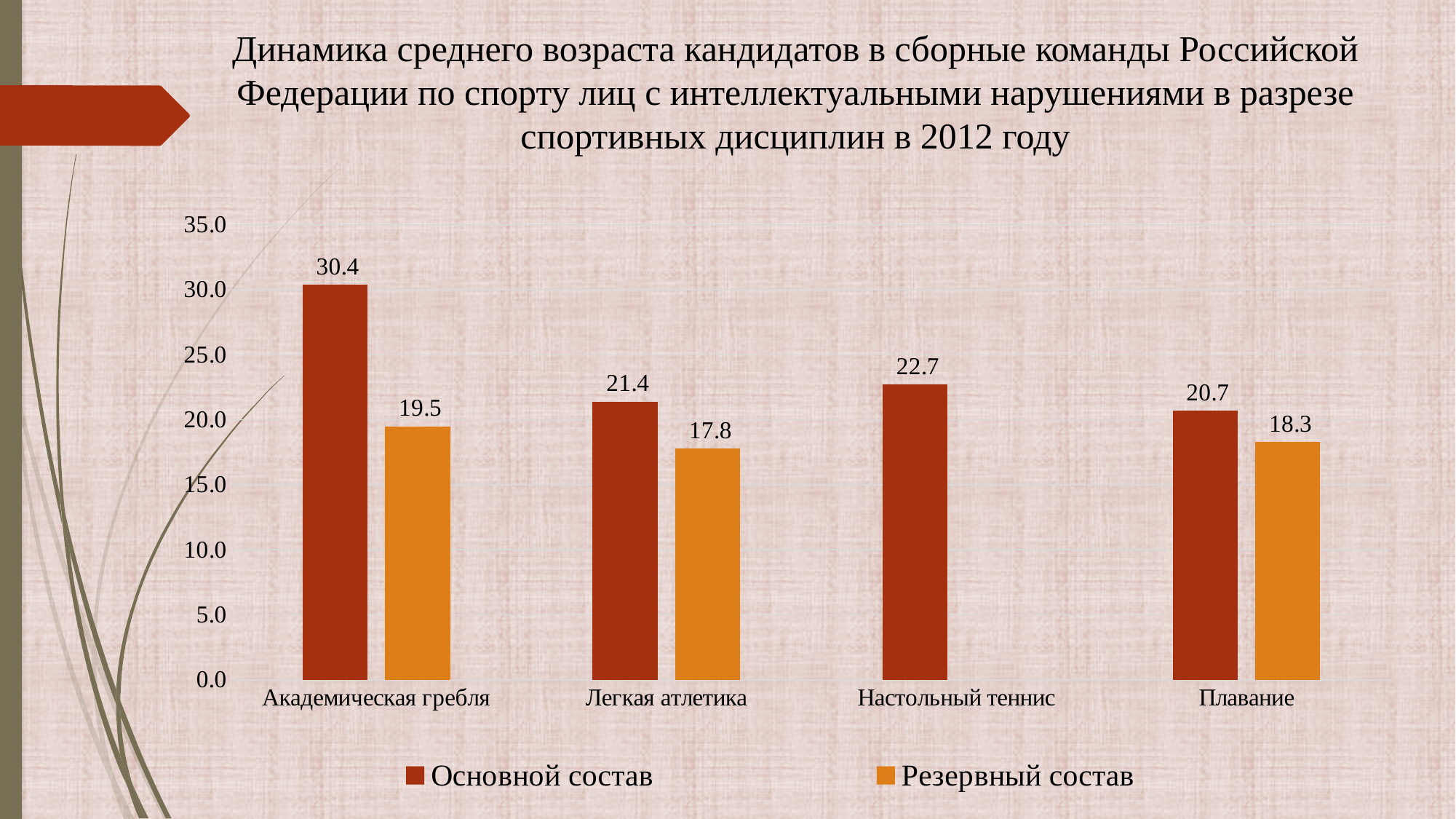
What is the value for Резервный состав in Плавание? 18.3 Which is larger: Основной состав in Настольный теннис or Основной состав in Легкая атлетика? Настольный теннис What is the value for Основной состав in Академическая гребля? 30.4 What is the value for Резервный состав in Легкая атлетика? 17.8 What is the difference between Основной состав and Резервный состав in Академическая гребля? 10.9 Which category has the lowest value for Резервный состав? Легкая атлетика What kind of chart is shown on the slide? bar chart Which category has the lowest value for Основной состав? Плавание Is the value for Основной состав in Настольный теннис greater or less than 20.0? greater Which category has the highest value for Основной состав? Академическая гребля How many series does the legend list? 2 How many categories are shown on the x axis? 4